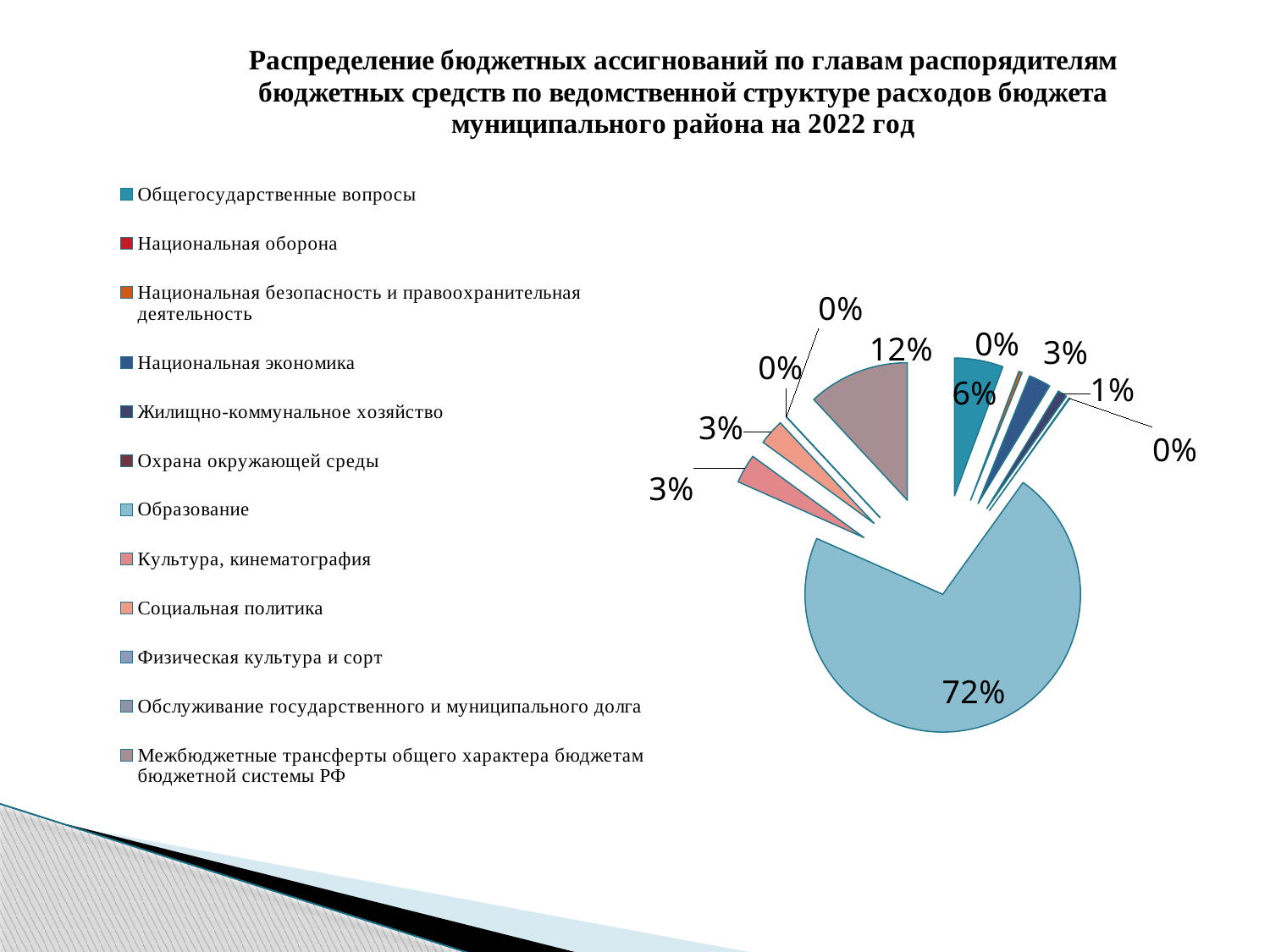
Which category has the largest share of the pie? Образование What share of the pie does Общегосударственные вопросы have? 6% What kind of chart is shown on the slide? pie chart Which is larger: the share for Образование or the share for Межбюджетные трансферты общего характера бюджетам бюджетной системы РФ? Образование How many categories does the legend of the pie chart list? 12 What year does the chart title say the budget allocation is for? 2022 What is the difference between the share for Межбюджетные трансферты общего характера бюджетам бюджетной системы РФ and the share for Общегосударственные вопросы? 6% What share of the pie does Культура, кинематография have? 3% Which is larger: the share for Общегосударственные вопросы or the share for Культура, кинематография? Общегосударственные вопросы What share of the pie does Межбюджетные трансферты общего характера бюджетам бюджетной системы РФ have? 12% What is the difference between the share for Образование and the share for Межбюджетные трансферты общего характера бюджетам бюджетной системы РФ? 60%